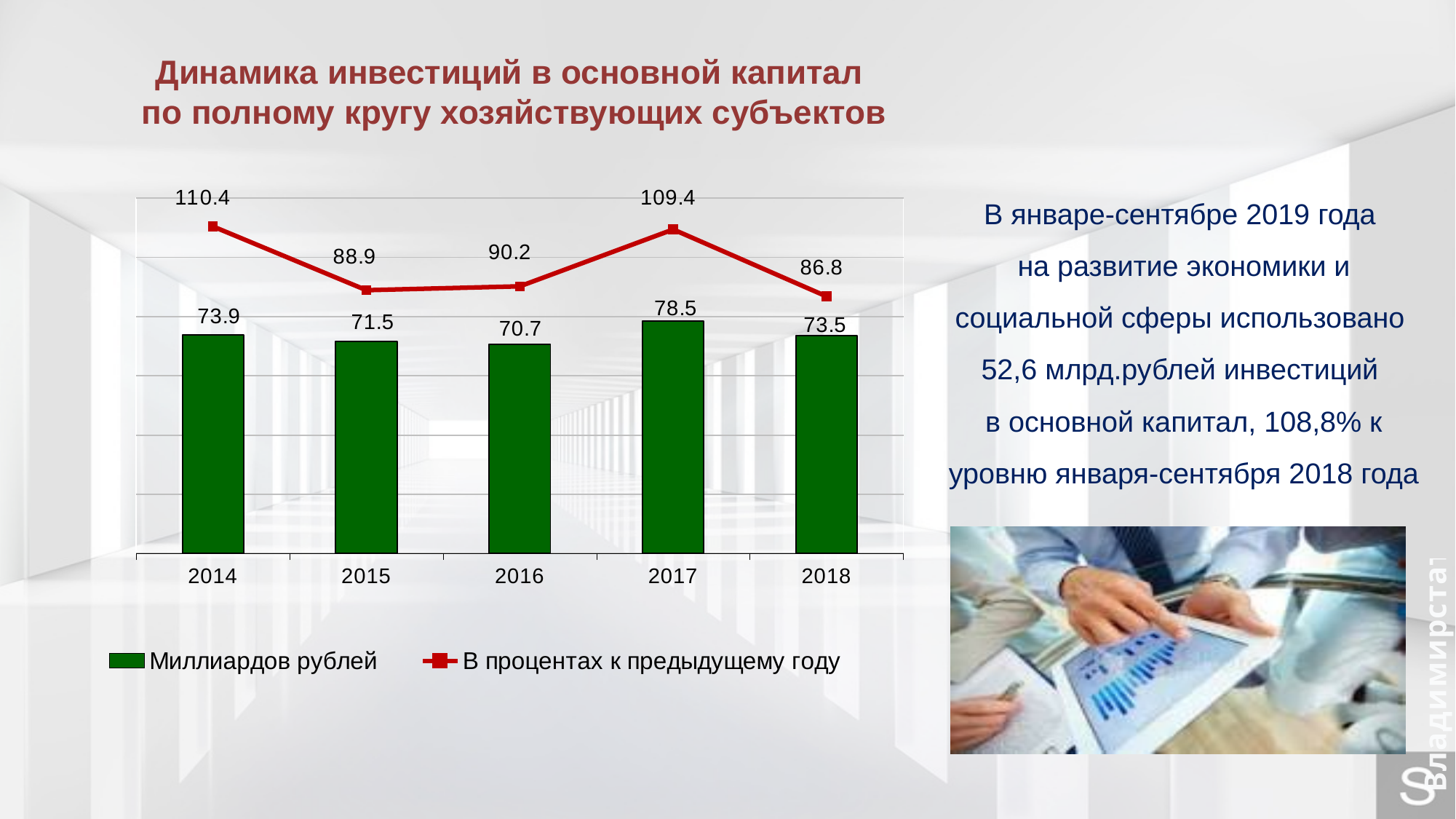
What is the value of 'Миллиардов рублей' for 2016? 70.7 Which is larger, the 'В процентах к предыдущему году' value for 2015 or for 2016? 2016 How many series does the chart legend list? 2 What is the value of 'В процентах к предыдущему году' for 2018? 86.8 What colour are the bars for 'Миллиардов рублей'? Green How many years are shown on the x axis of the chart? 5 Which year has the lowest value of 'В процентах к предыдущему году'? 2018 What kind of chart is shown on the slide? Combined bar and line chart What is the value of 'В процентах к предыдущему году' for 2014? 110.4 Which year has the highest value of 'Миллиардов рублей'? 2017 What is the difference between the 'Миллиардов рублей' values for 2017 and 2016? 7.8 What is the value of 'Миллиардов рублей' for 2017? 78.5